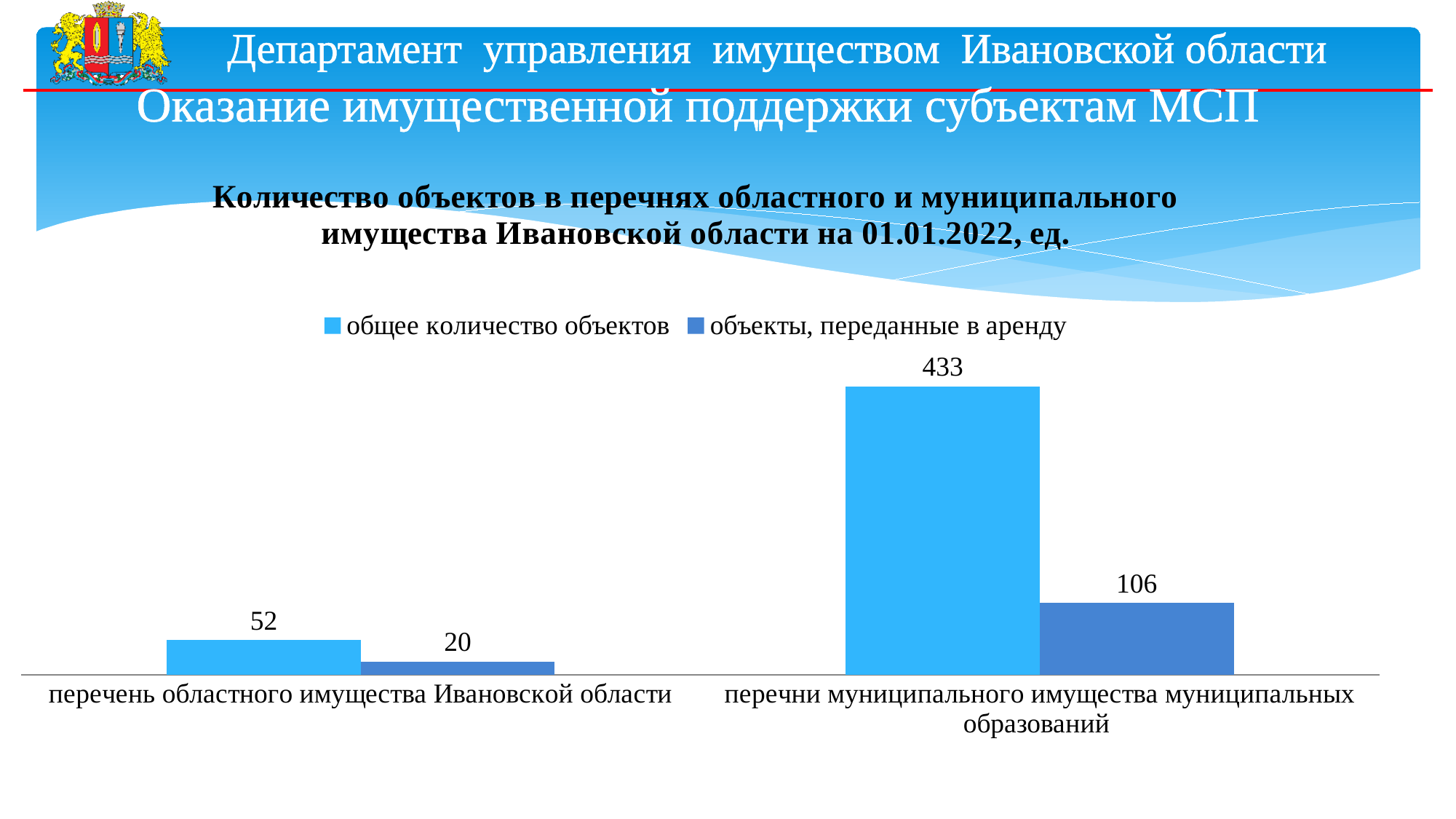
How many categories are shown on the x axis? 2 What is the value of 'объекты, переданные в аренду' for 'перечень областного имущества Ивановской области'? 20 What kind of chart is shown on the slide? bar chart Which category has the lowest value for 'объекты, переданные в аренду'? перечень областного имущества Ивановской области What is the difference between 'общее количество объектов' and 'объекты, переданные в аренду' for 'перечень областного имущества Ивановской области'? 32 What is the value of 'объекты, переданные в аренду' for 'перечни муниципального имущества муниципальных образований'? 106 Which is larger: 'объекты, переданные в аренду' for 'перечни муниципального имущества муниципальных образований' or 'общее количество объектов' for 'перечень областного имущества Ивановской области'? объекты, переданные в аренду for перечни муниципального имущества муниципальных образований Which category has the highest value for 'общее количество объектов'? перечни муниципального имущества муниципальных образований What is the value of 'общее количество объектов' for 'перечни муниципального имущества муниципальных образований'? 433 How many series does the legend list? 2 What is the difference between 'общее количество объектов' and 'объекты, переданные в аренду' for 'перечни муниципального имущества муниципальных образований'? 327 What is the value of 'общее количество объектов' for 'перечень областного имущества Ивановской области'? 52